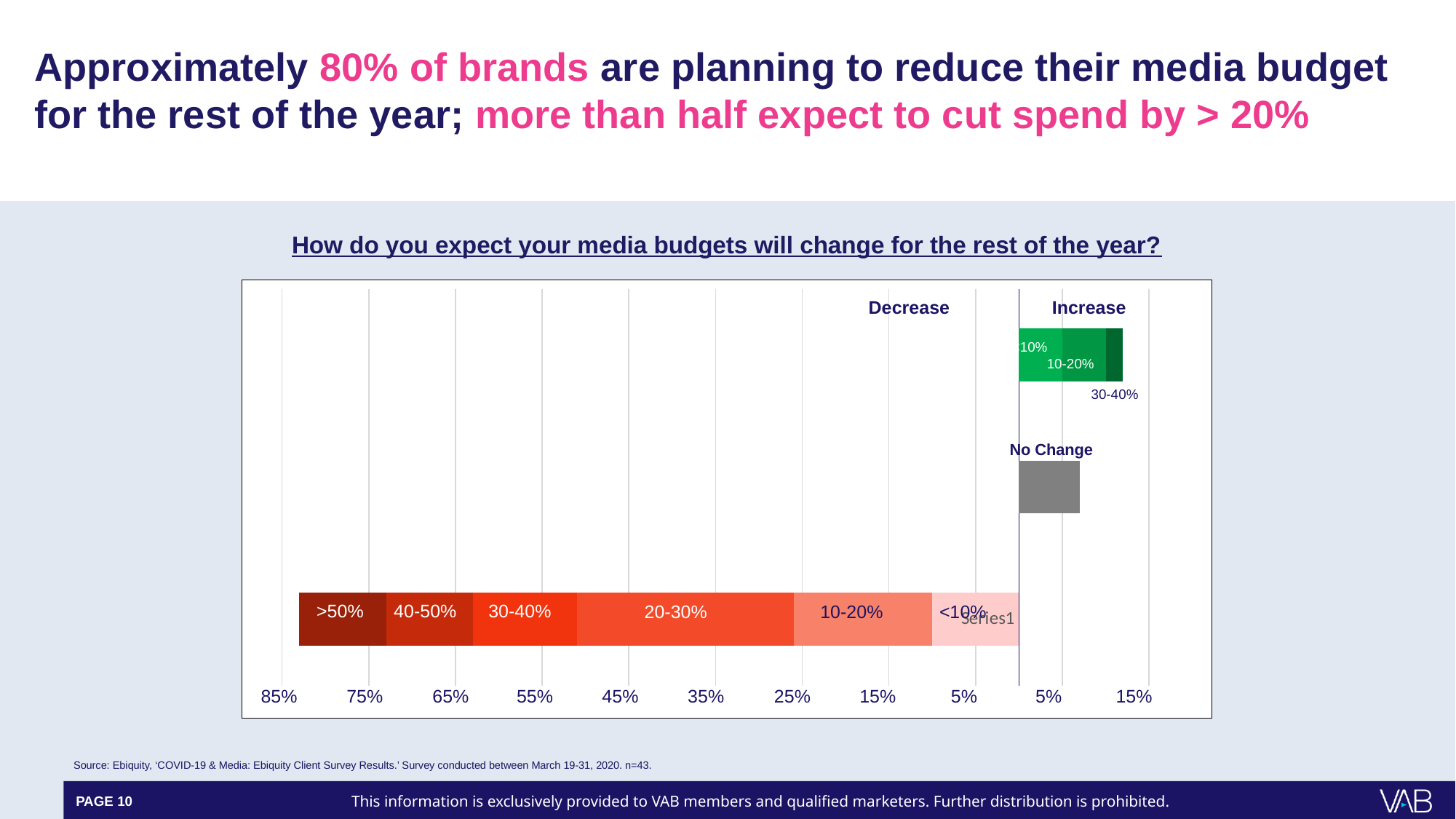
Which is longer overall, the Decrease bar or the Increase bar? Decrease What colour are the segments of the Increase bar? green What kind of chart is shown on the slide? bar chart Is the total length of the Increase bar greater or less than 5%? greater Is the total length of the Decrease bar greater or less than 75%? greater How many segments make up the Decrease bar? 6 What is the title of the chart? How do you expect your media budgets will change for the rest of the year? Which segment of the Decrease bar is wider, 20-30% or 40-50%? 20-30% Which segment of the Decrease bar is the widest? 20-30% How many segments make up the Increase bar? 3 Is the No Change bar greater or less than 15%? less